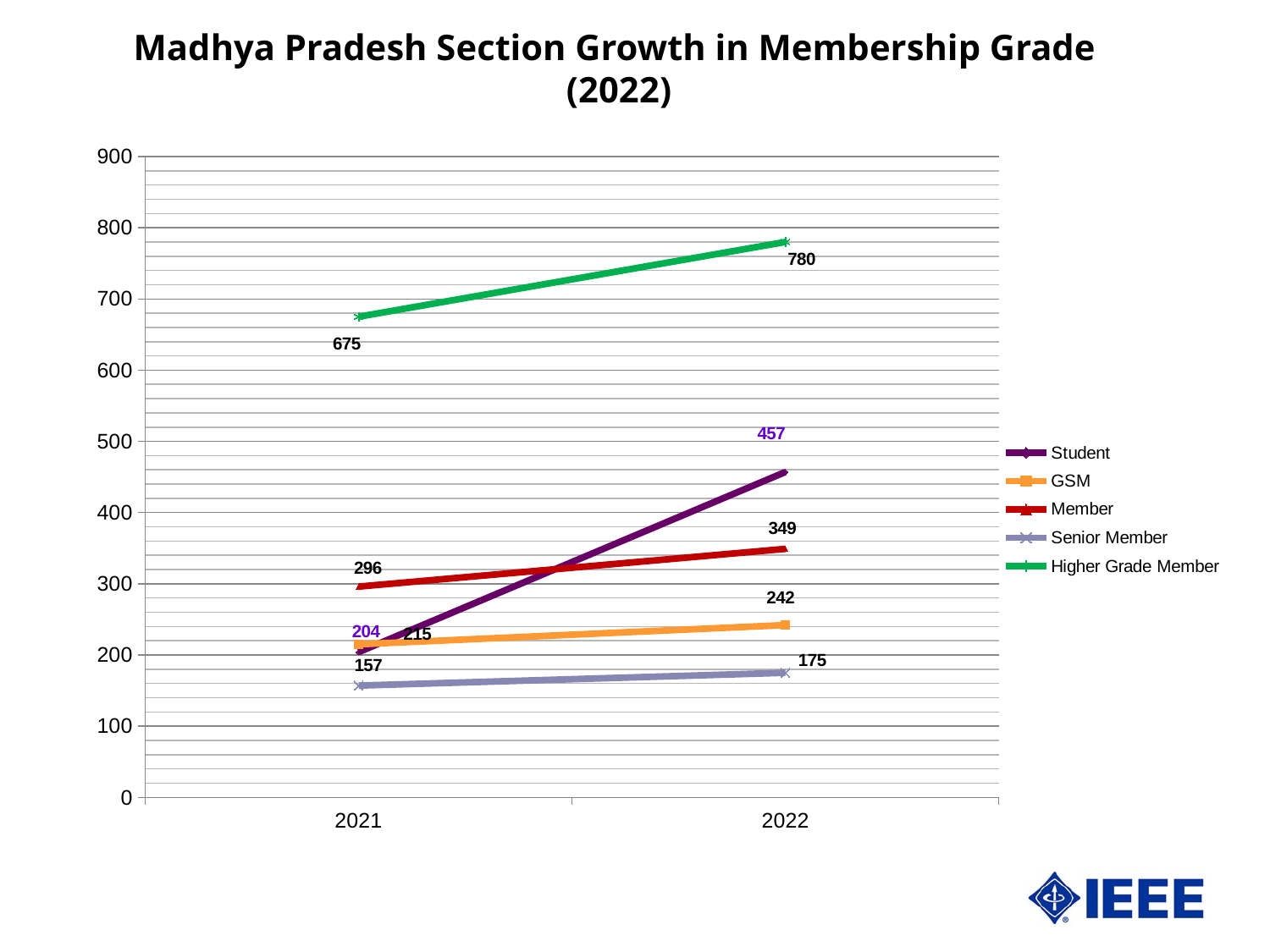
In 2022, which is larger: the Student value or the Member value? Student What is the value for Student in 2021? 204 What is the difference between the Higher Grade Member values in 2022 and 2021? 105 How many series does the legend list? 5 Does the GSM series rise or fall from 2021 to 2022? Rise By how much did the Student value increase from 2021 to 2022? 253 What kind of chart is shown on the slide? Line chart What is the value for Higher Grade Member in 2022? 780 What is the value for Senior Member in 2021? 157 Which series has the highest value in 2022? Higher Grade Member Which series has the lowest value in 2021? Senior Member What is the value for Member in 2022? 349